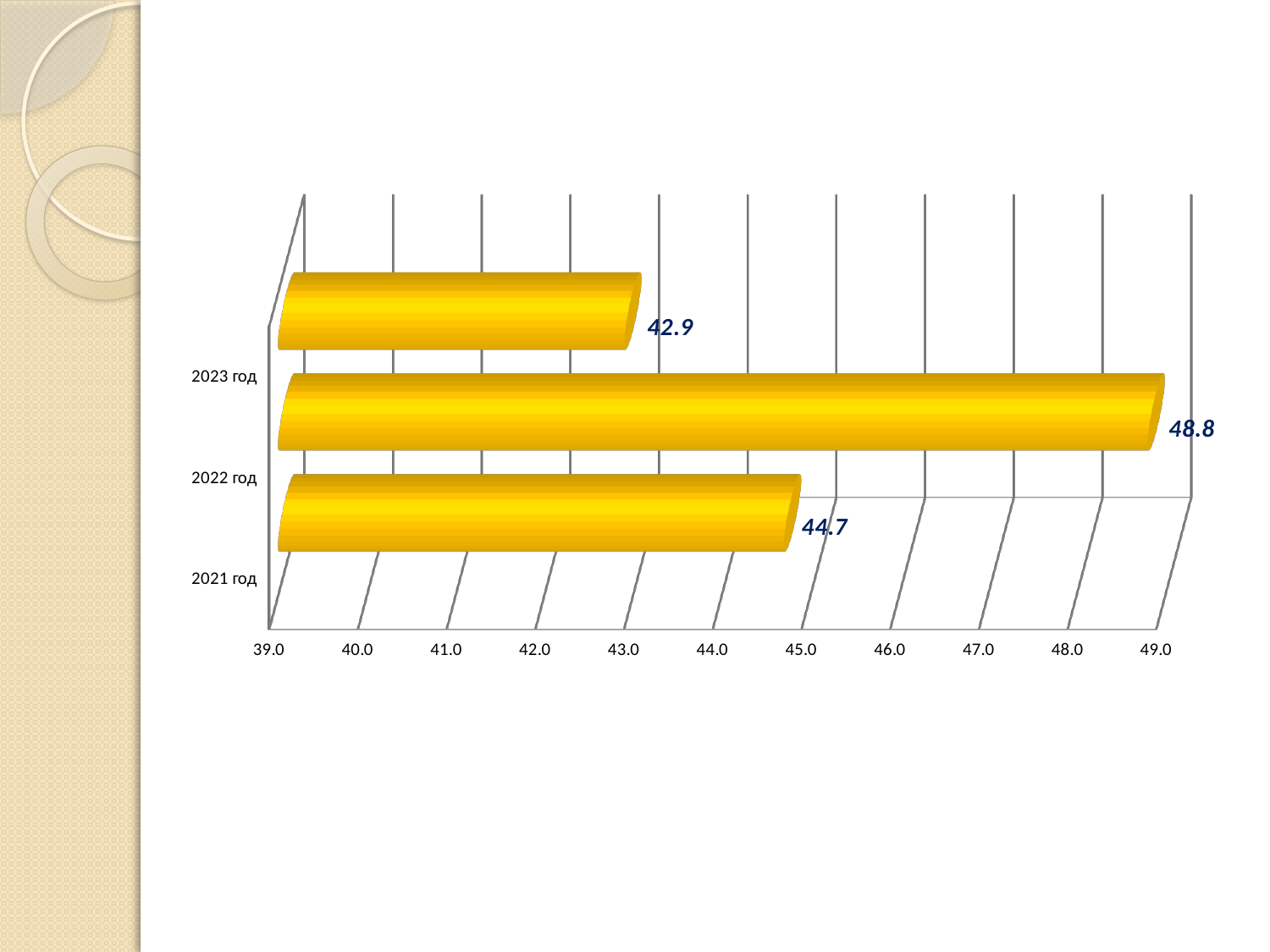
What is the difference between the values for 2021 год and 2023 год? 1.8 Is the value for 2022 год greater or less than 47.0? greater What is the difference between the values for 2022 год and 2023 год? 5.9 Which year has the highest value? 2022 год What colour are the bars in the chart? yellow Which year has the lowest value? 2023 год What kind of chart is shown on the slide? bar chart Which is larger, the value for 2021 год or the value for 2023 год? 2021 год How many bars are shown in the chart? 3 What is the value for 2023 год? 42.9 What is the value for 2022 год? 48.8 What is the value for 2021 год? 44.7